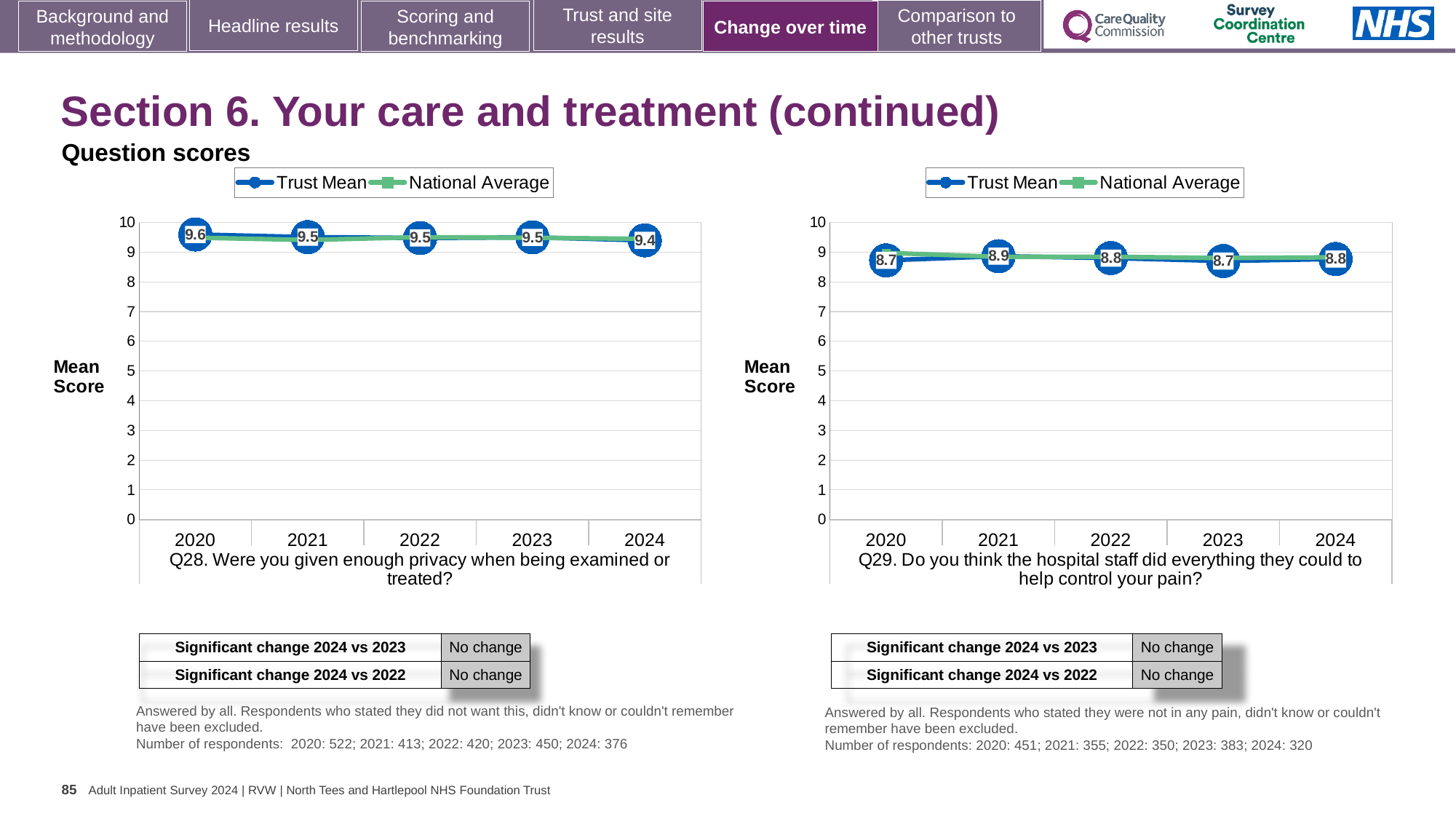
In the Q29 chart on the right, is the Trust Mean score for 2021 or 2023 larger? 2021 In the Q28 chart on the left, what is the Trust Mean score for 2024? 9.4 What kind of chart is the Q29 chart on the right? Line chart In the Q28 chart on the left, what is the difference between the Trust Mean scores for 2020 and 2024? 0.2 In the Q29 chart on the right, is the National Average for 2024 greater or less than 8? greater In the Q29 chart on the right, what is the Trust Mean score for 2021? 8.9 In the Q28 chart on the left, which year has the lowest Trust Mean score? 2024 In the Q29 chart on the right, what is the Trust Mean score for 2024? 8.8 In the Q28 chart on the left, what is the Trust Mean score for 2020? 9.6 In the Q28 chart on the left, which year has the highest Trust Mean score? 2020 In the Q29 chart on the right, which year has the highest Trust Mean score? 2021 How many series does the legend of the Q28 chart on the left list? 2